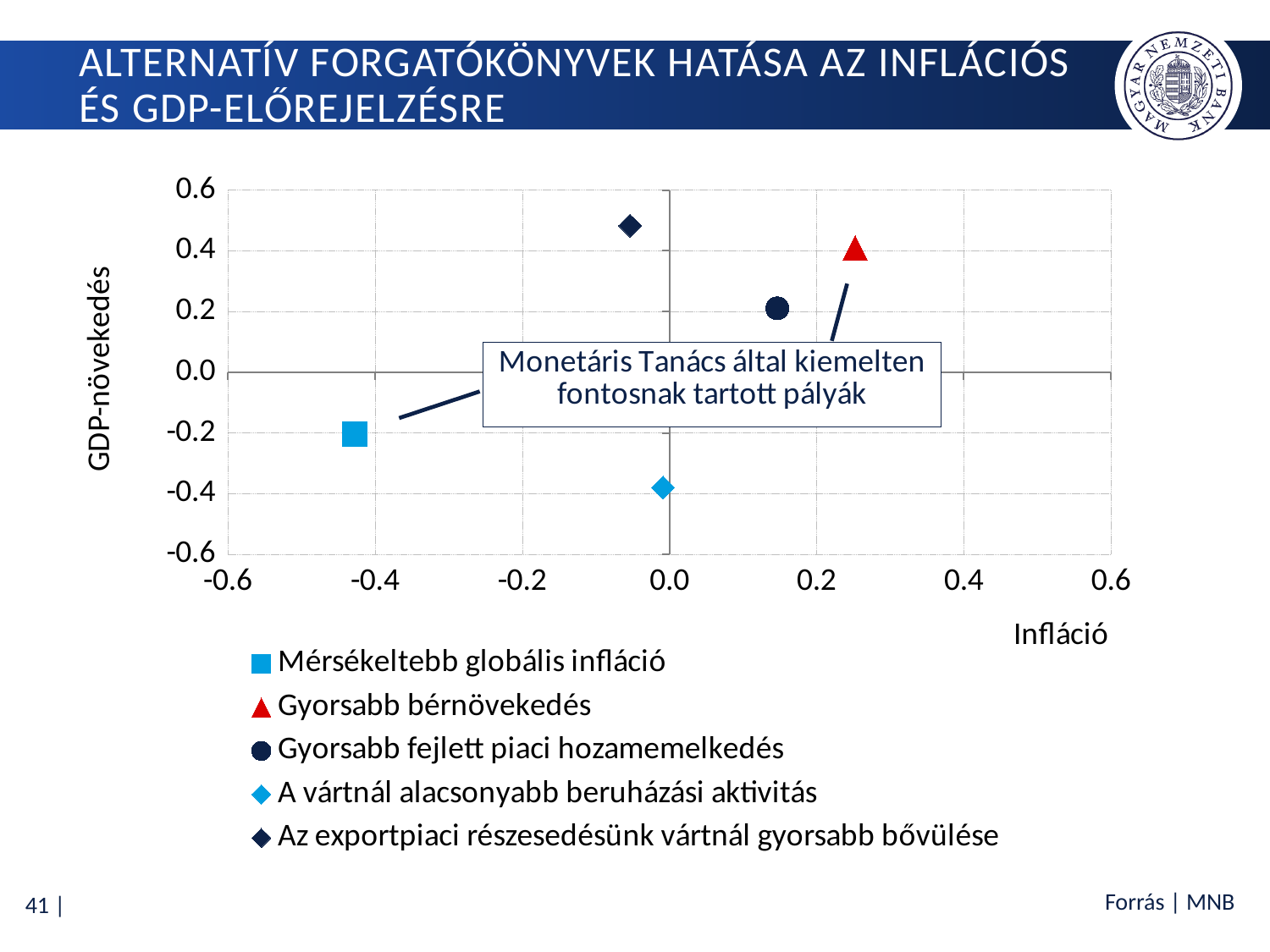
What kind of chart is shown on the slide? Scatter chart Which has the larger GDP-növekedés value: Gyorsabb bérnövekedés or Gyorsabb fejlett piaci hozamemelkedés? Gyorsabb bérnövekedés How many series does the legend list? 5 Is the GDP-növekedés value for Gyorsabb bérnövekedés greater or less than 0.2? greater What is the label of the horizontal axis? Infláció Which series has the lowest Infláció value? Mérsékeltebb globális infláció Which series has the lowest GDP-növekedés value? A vártnál alacsonyabb beruházási aktivitás Which series has the highest GDP-növekedés value? Az exportpiaci részesedésünk vártnál gyorsabb bővülése Is the GDP-növekedés value for A vártnál alacsonyabb beruházási aktivitás greater or less than -0.2? less Which series has the highest Infláció value? Gyorsabb bérnövekedés Is the Infláció value for Mérsékeltebb globális infláció greater or less than -0.2? less How many data points are plotted on the chart? 5